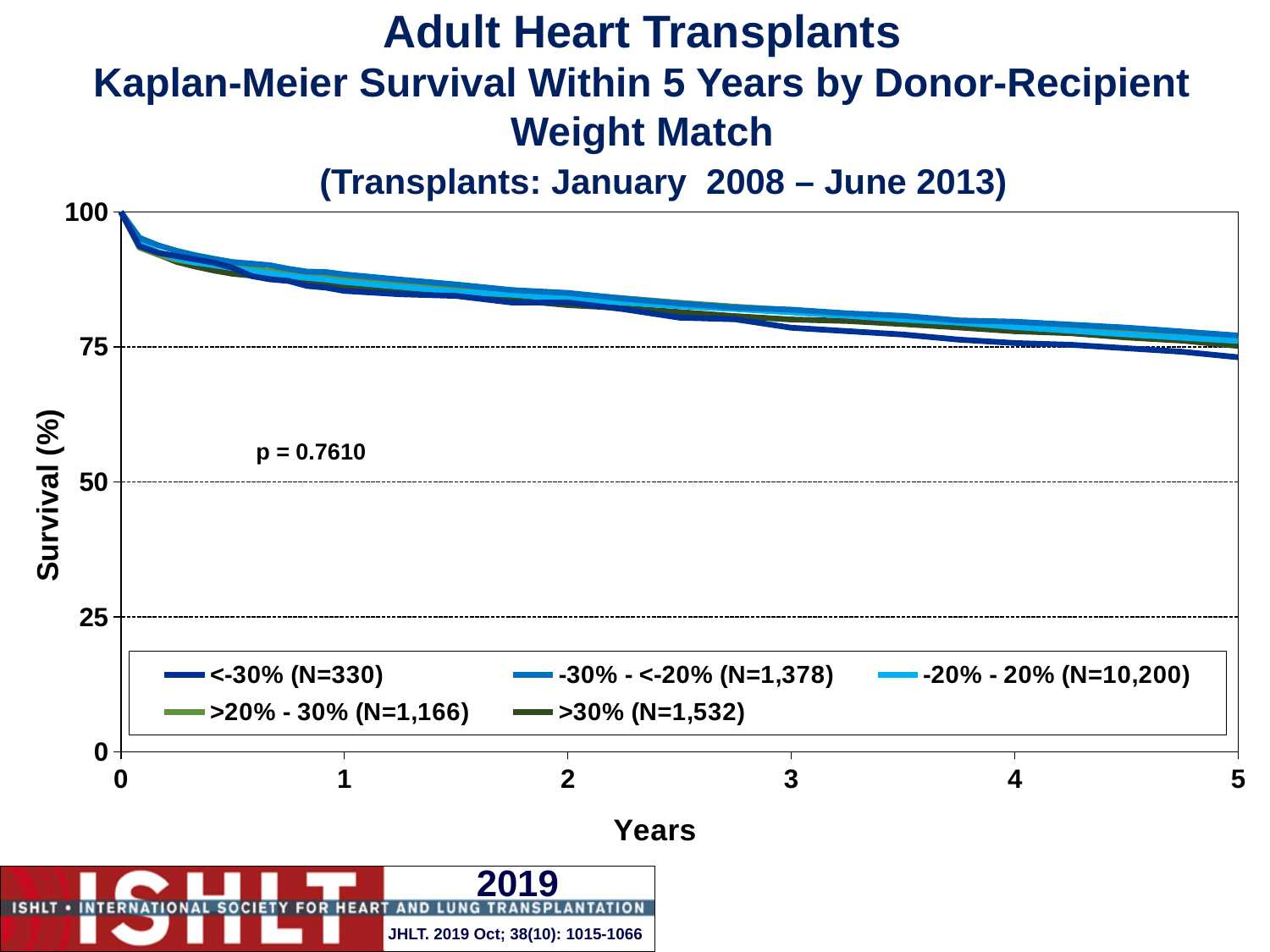
Is the survival value for the -20% - 20% (N=10,200) group at year 5 greater or less than 50? greater Is the survival value for the <-30% (N=330) group at year 5 greater or less than 75? less Do the survival curves rise or fall as the years increase? fall What is the N for the -20% - 20% group in the legend? N=10,200 Is the survival value for the >30% (N=1,532) group at year 3 greater or less than 75? greater How many series does the legend list? 5 Which group has the lowest survival at year 5? <-30% (N=330) At year 5, which is larger: the survival of the <-30% (N=330) group or the -20% - 20% (N=10,200) group? -20% - 20% (N=10,200) What is the p-value shown on the chart? p = 0.7610 What kind of chart is shown on the slide? line chart